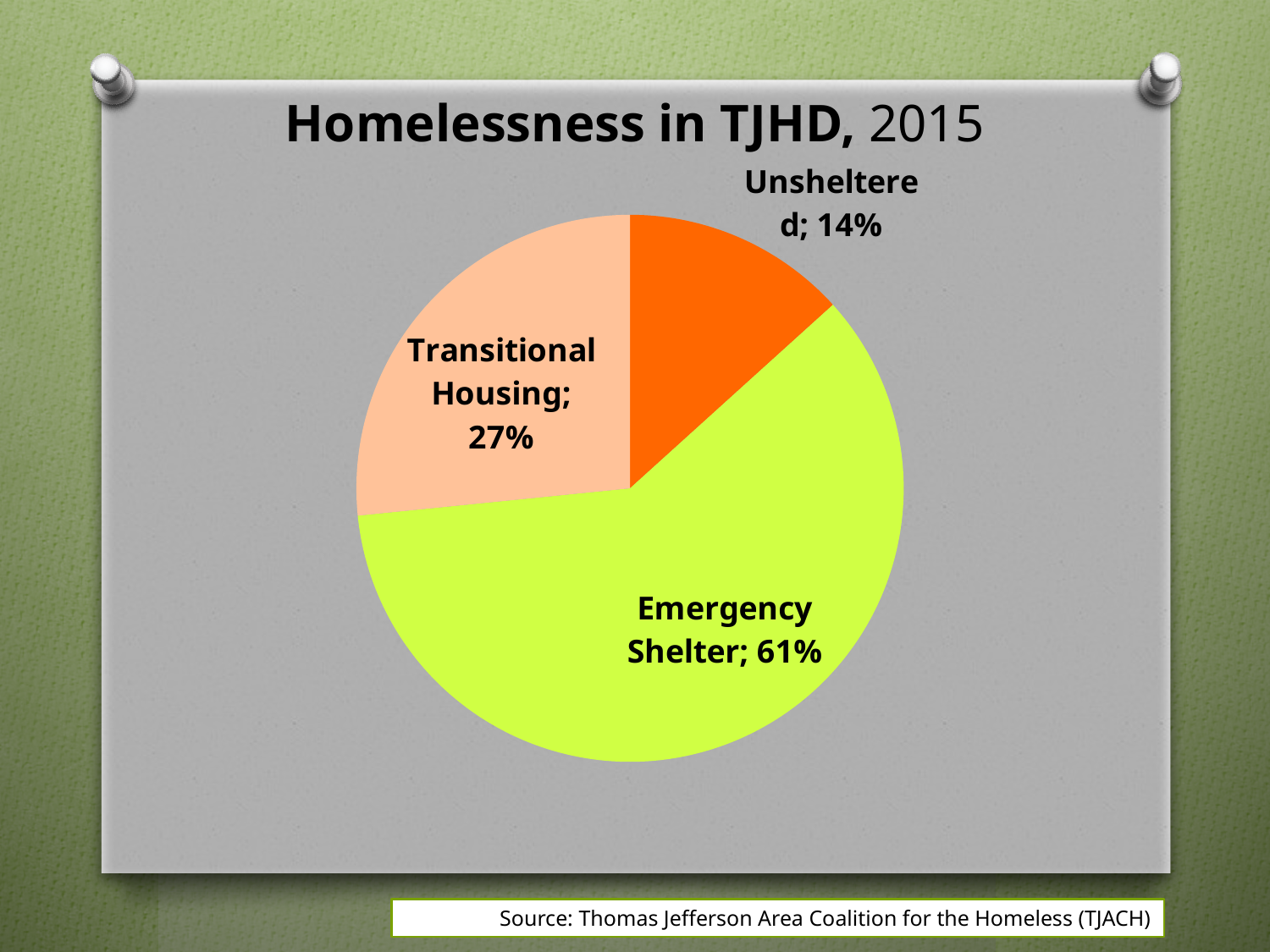
Which category has the largest slice of the pie? Emergency Shelter How many slices does the pie chart have? 3 Which is larger, the Transitional Housing slice or the Unsheltered slice? Transitional Housing What is the difference in percentage points between Transitional Housing and Unsheltered? 13 What share of the pie is Unsheltered? 14% What colour is the Emergency Shelter slice? Yellow-green What share of the pie is Emergency Shelter? 61% What kind of chart is shown on the slide? Pie chart What is the title of the chart? Homelessness in TJHD, 2015 Which category has the smallest slice of the pie? Unsheltered What share of the pie is Transitional Housing? 27% What is the difference in percentage points between Emergency Shelter and Transitional Housing? 34